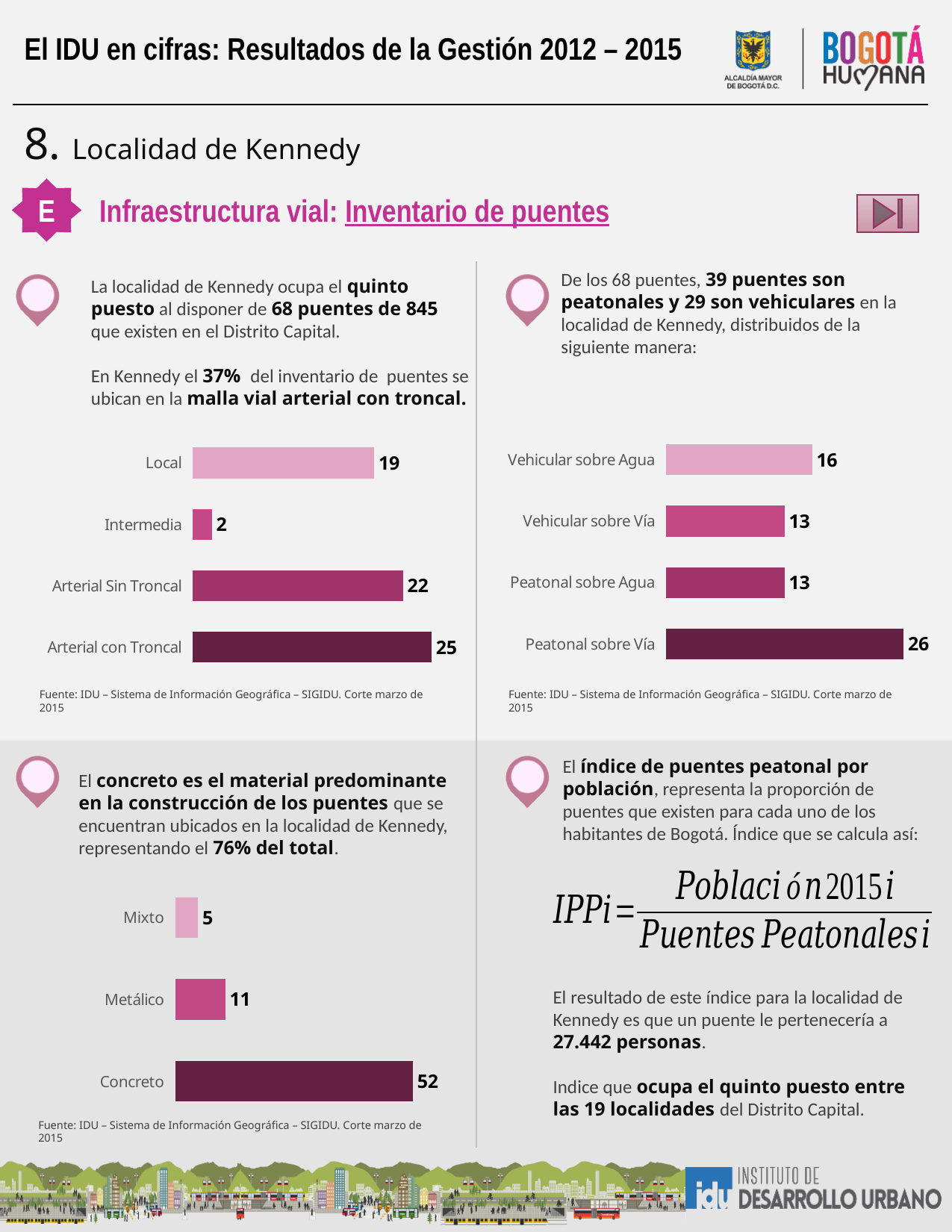
In the top-right chart, which category has the highest value? Peatonal sobre Vía How many categories does the bottom-left chart show? 3 In the top-right chart, what is the value for Peatonal sobre Vía? 26 In the top-right chart, which is larger: Vehicular sobre Agua or Vehicular sobre Vía? Vehicular sobre Agua In the top-left chart, what is the value for Arterial con Troncal? 25 In the bottom-left chart, which category has the highest value? Concreto In the bottom-left chart, what is the value for Metálico? 11 How many categories does the top-left chart show? 4 In the top-left chart, what is the difference between Arterial Sin Troncal and Local? 3 What kind of chart is the bottom-left chart? Bar chart In the top-left chart, which category has the lowest value? Intermedia In the top-right chart, what is the difference between Peatonal sobre Vía and Peatonal sobre Agua? 13